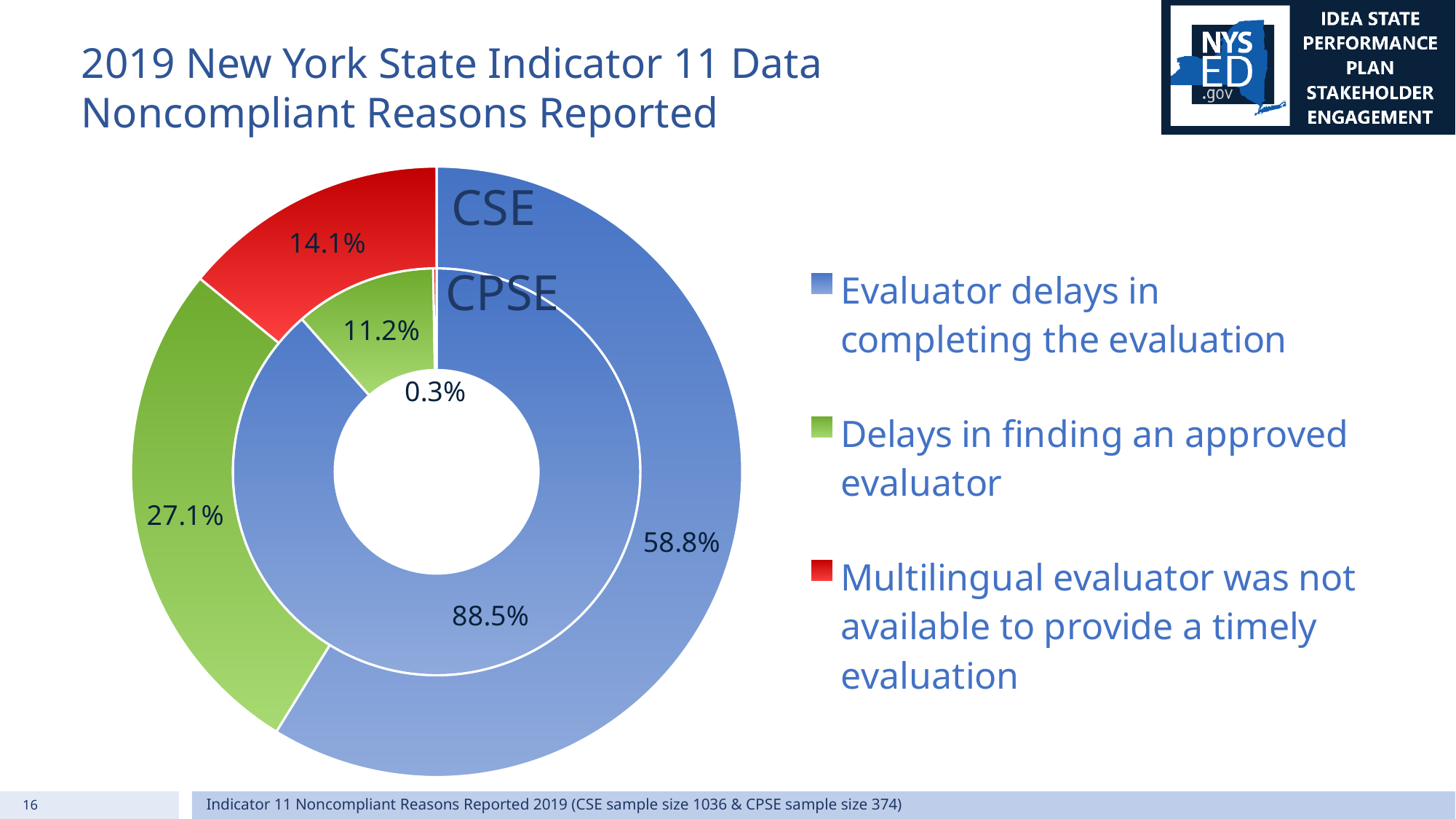
What kind of chart is shown on the slide? Doughnut chart What is the difference between the CPSE and CSE shares for 'Evaluator delays in completing the evaluation'? 29.7% In the CPSE ring, what share is reported for 'Evaluator delays in completing the evaluation'? 88.5% Which is larger: the CSE share for 'Multilingual evaluator was not available to provide a timely evaluation' or the CPSE share for the same reason? CSE In the CSE ring, what share is reported for 'Evaluator delays in completing the evaluation'? 58.8% Which ring of the doughnut chart represents CPSE, the inner or the outer? Inner In the CPSE ring, what share is reported for 'Multilingual evaluator was not available to provide a timely evaluation'? 0.3% How many series does the legend list? 3 In the CSE ring, what share is reported for 'Delays in finding an approved evaluator'? 27.1% Which reason has the smallest share in the CPSE ring? Multilingual evaluator was not available to provide a timely evaluation What colour represents 'Delays in finding an approved evaluator' in the chart? Green Which reason has the largest share in the CSE ring? Evaluator delays in completing the evaluation